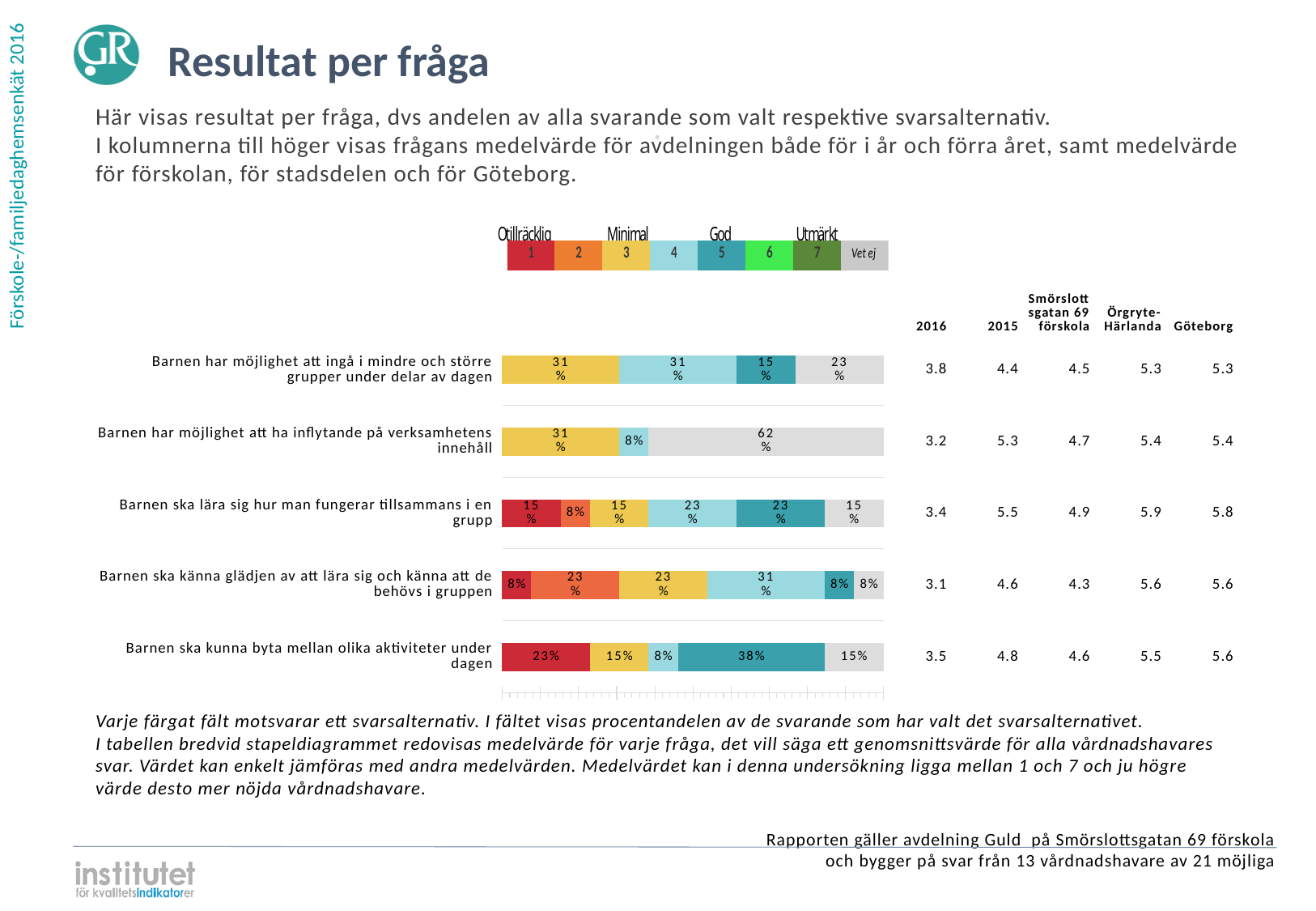
What percentage chose option 5 (teal) for 'Barnen ska kunna byta mellan olika aktiviteter under dagen'? 38% How many response options does the legend above the chart list, including 'Vet ej'? 8 How many questions (categories) are shown as bars in the chart? 5 For 'Barnen ska kunna byta mellan olika aktiviteter under dagen', which is larger: the option 5 share or the option 1 share? Option 5 (38%) What percentage chose option 1 (red) for 'Barnen ska kunna byta mellan olika aktiviteter under dagen'? 23% Which question has the largest 'Vet ej' share? Barnen har möjlighet att ha inflytande på verksamhetens innehåll What is the 2016 mean value shown for 'Barnen ska känna glädjen av att lära sig och känna att de behövs i gruppen'? 3.1 What percentage chose option 4 (light blue) for 'Barnen ska känna glädjen av att lära sig och känna att de behövs i gruppen'? 31% What label does the legend give to response options 1 and 2? Otillräcklig For 'Barnen ska lära sig hur man fungerar tillsammans i en grupp', what is the difference between the option 4 share and the option 2 share? 15 percentage points What percentage of respondents answered 'Vet ej' for 'Barnen har möjlighet att ha inflytande på verksamhetens innehåll'? 62% What kind of chart is used to show the results per question? Stacked bar chart